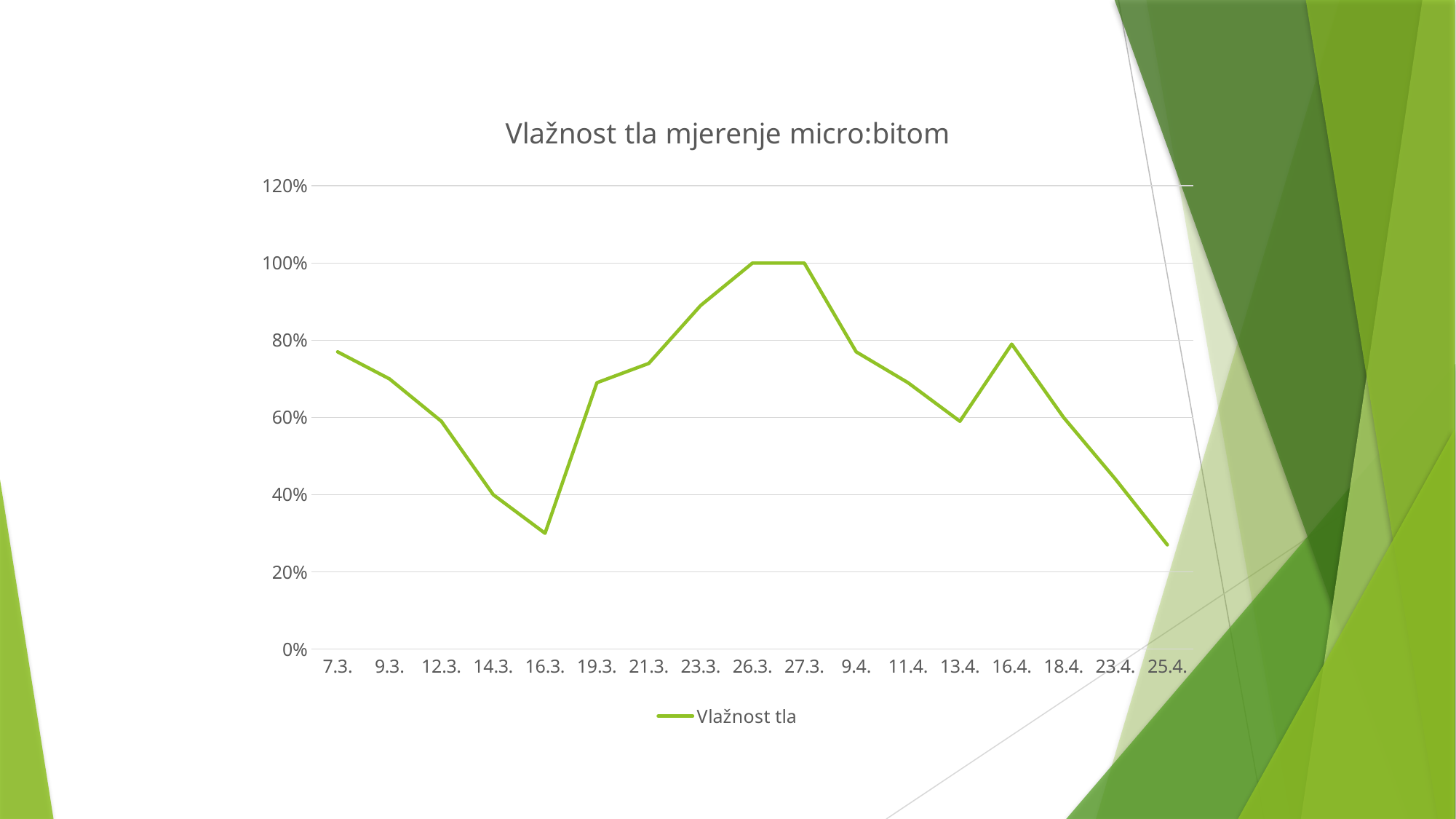
What is the value for 26.3.? 100% What is the title of the chart? Vlažnost tla mjerenje micro:bitom Is the value for 16.3. greater or less than 40%? less Is the value for 23.3. greater or less than 80%? greater Which is larger, the value for 16.3. or the value for 19.3.? 19.3. How many series does the legend list? 1 What kind of chart is shown on the slide? line chart How many dates are plotted along the x axis? 17 Do the values rise or fall from 16.4. to 25.4.? fall Do the values rise or fall from 16.3. to 26.3.? rise What is the value for 27.3.? 100% Is the value for 9.3. greater or less than 60%? greater